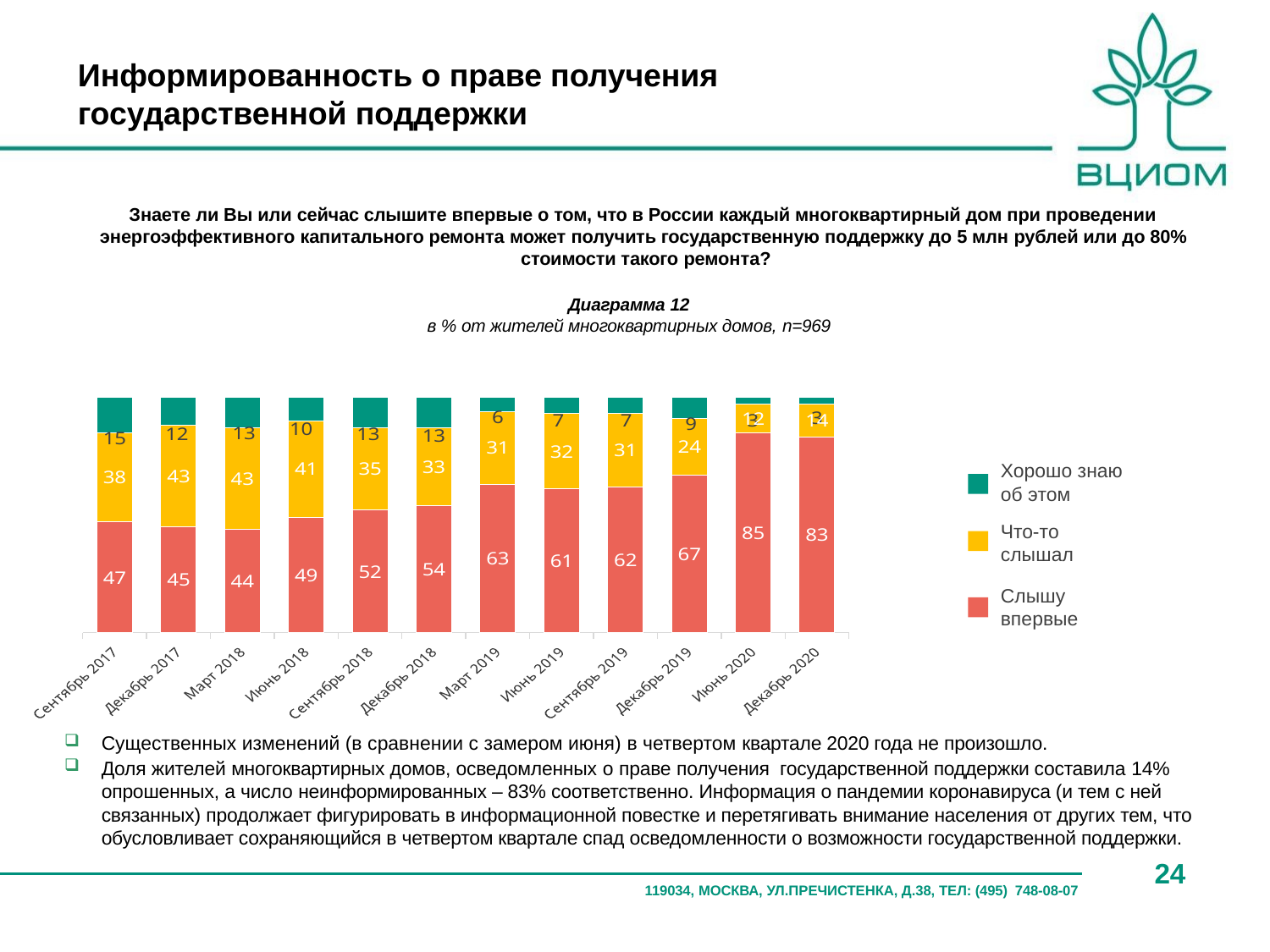
How many time periods (bars) are shown on the x axis? 12 What is the value of "Что-то слышал" for Декабрь 2017? 43 What is the difference between the "Слышу впервые" values for Декабрь 2019 and Сентябрь 2019? 5 What is the value of "Хорошо знаю об этом" for Июнь 2018? 10 Does the "Слышу впервые" series generally rise or fall from Сентябрь 2017 to Декабрь 2020? rise Which is larger: the "Что-то слышал" value for Сентябрь 2018 or for Декабрь 2019? Сентябрь 2018 How many series does the legend list? 3 What is the value of "Слышу впервые" for Июнь 2020? 85 What is the value of "Слышу впервые" for Сентябрь 2017? 47 What kind of chart is shown on the slide? stacked bar chart Which period has the lowest value for "Слышу впервые"? Март 2018 Which period has the highest value for "Слышу впервые"? Июнь 2020